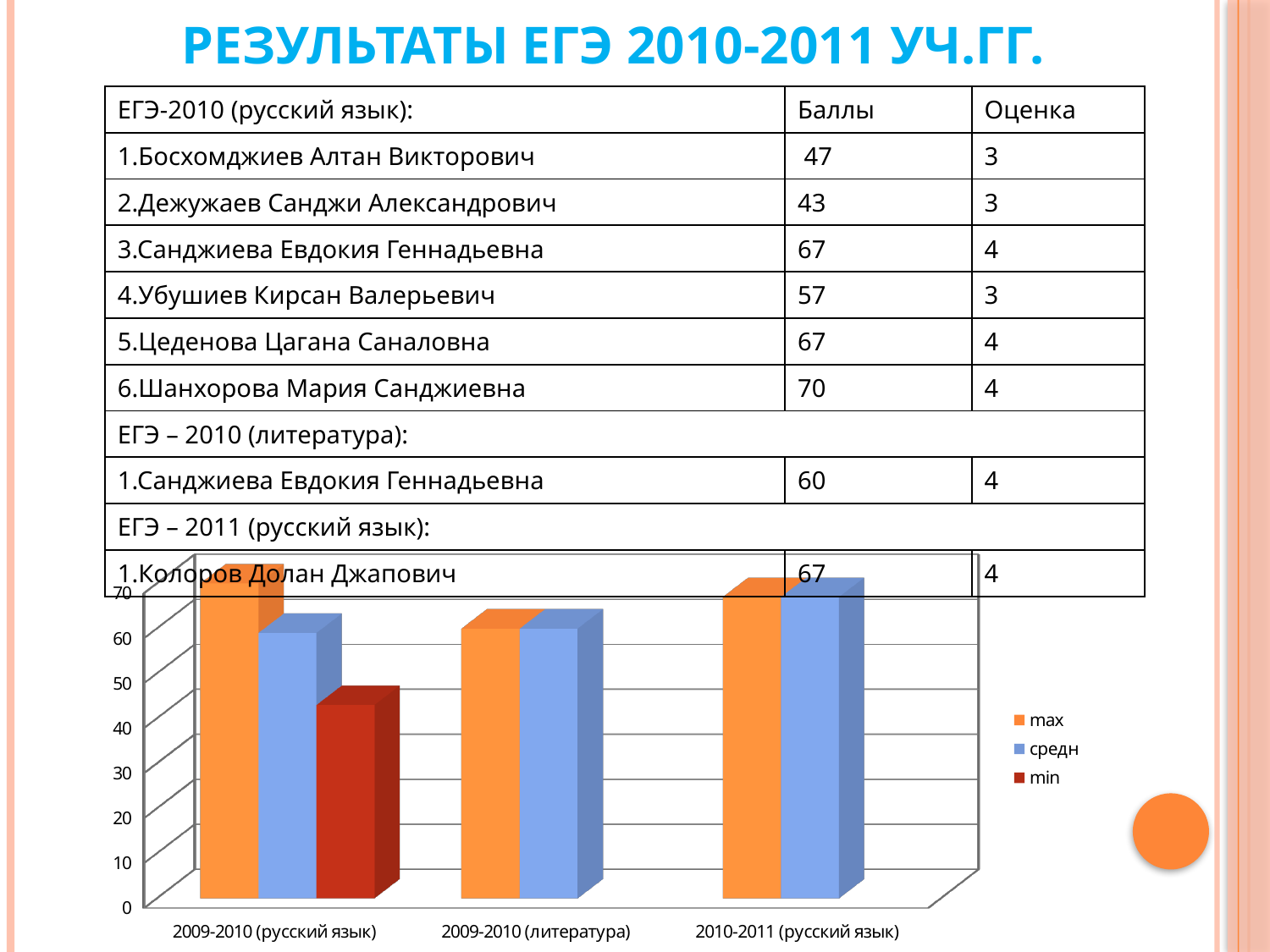
How many categories are shown on the x axis of the chart? 3 Which category is the only one with a 'min' bar shown in the chart? 2009-2010 (русский язык) Which colour represents the 'min' series in the chart? red Which category has the highest 'max' bar in the chart? 2009-2010 (русский язык) Is the 'min' value for 2009-2010 (русский язык) greater or less than 50? less Which is larger: the 'max' value for 2009-2010 (русский язык) or the 'max' value for 2009-2010 (литература)? 2009-2010 (русский язык) What kind of chart is shown on the slide? bar chart Which category has the lowest 'max' bar in the chart? 2009-2010 (литература) Is the 'max' value for 2010-2011 (русский язык) greater or less than 60? greater Is the 'max' value for 2009-2010 (русский язык) greater or less than 60? greater How many series does the chart legend list? 3 What are the series names listed in the chart legend? max, средн, min